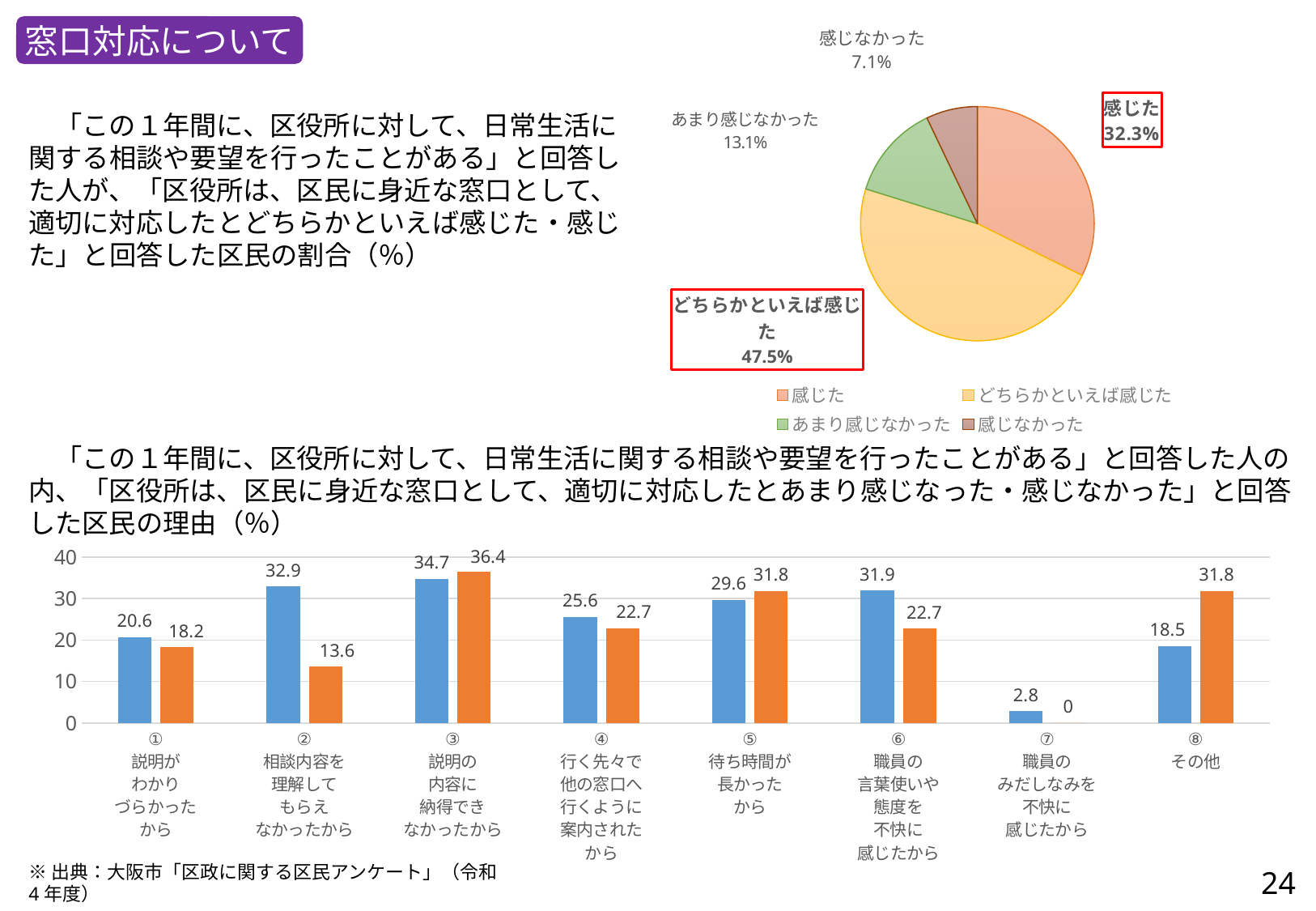
In the pie chart at the top right, what share of respondents answered 「感じなかった」? 7.1% In the pie chart at the top right, what is the difference in percentage points between 「感じた」 and 「あまり感じなかった」? 19.2 What kind of chart is the chart at the bottom of the slide? bar chart In the bar chart at the bottom, which category has the highest orange bar? ③ 説明の内容に納得できなかったから In the bar chart at the bottom, what is the value of the blue bar for category ② 相談内容を理解してもらえなかったから? 32.9 In the bar chart at the bottom, for category ⑥ 職員の言葉使いや態度を不快に感じたから, which is larger, the blue bar or the orange bar? the blue bar In the pie chart at the top right, what share of respondents answered 「どちらかといえば感じた」? 47.5% In the bar chart at the bottom, which category has the lowest blue bar? ⑦ 職員のみだしなみを不快に感じたから In the pie chart at the top right, how many categories does the legend list? 4 In the pie chart at the top right, which response has the smallest share? 感じなかった In the bar chart at the bottom, what is the value of the orange bar for category ⑧ その他? 31.8 In the pie chart at the top right, which response has the largest share? どちらかといえば感じた